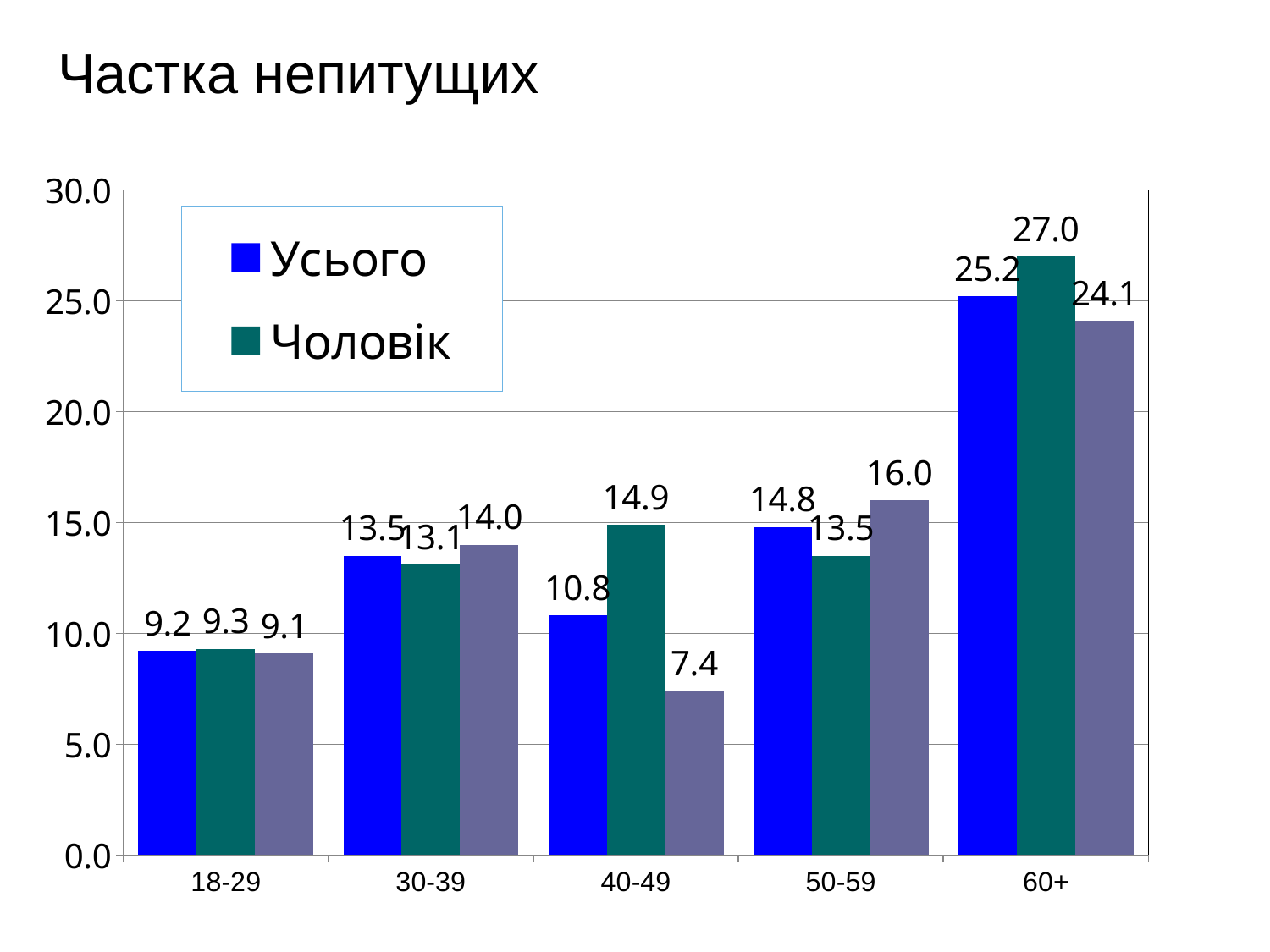
What is the title of the chart? Частка непитущих How many series does the legend list? 2 Which age group has the lowest value for Усього? 18-29 What is the value for Усього in the 60+ age group? 25.2 What is the value for Усього in the 30-39 age group? 13.5 Is the value for Чоловік in the 60+ age group greater or less than 25.0? greater Which age group has the highest value for Чоловік? 60+ Which is larger in the 50-59 age group: Усього or Чоловік? Усього What kind of chart is shown on the slide? bar chart What is the value for Чоловік in the 40-49 age group? 14.9 How many age groups are shown on the x axis? 5 What is the difference between the Чоловік and Усього values in the 60+ age group? 1.8